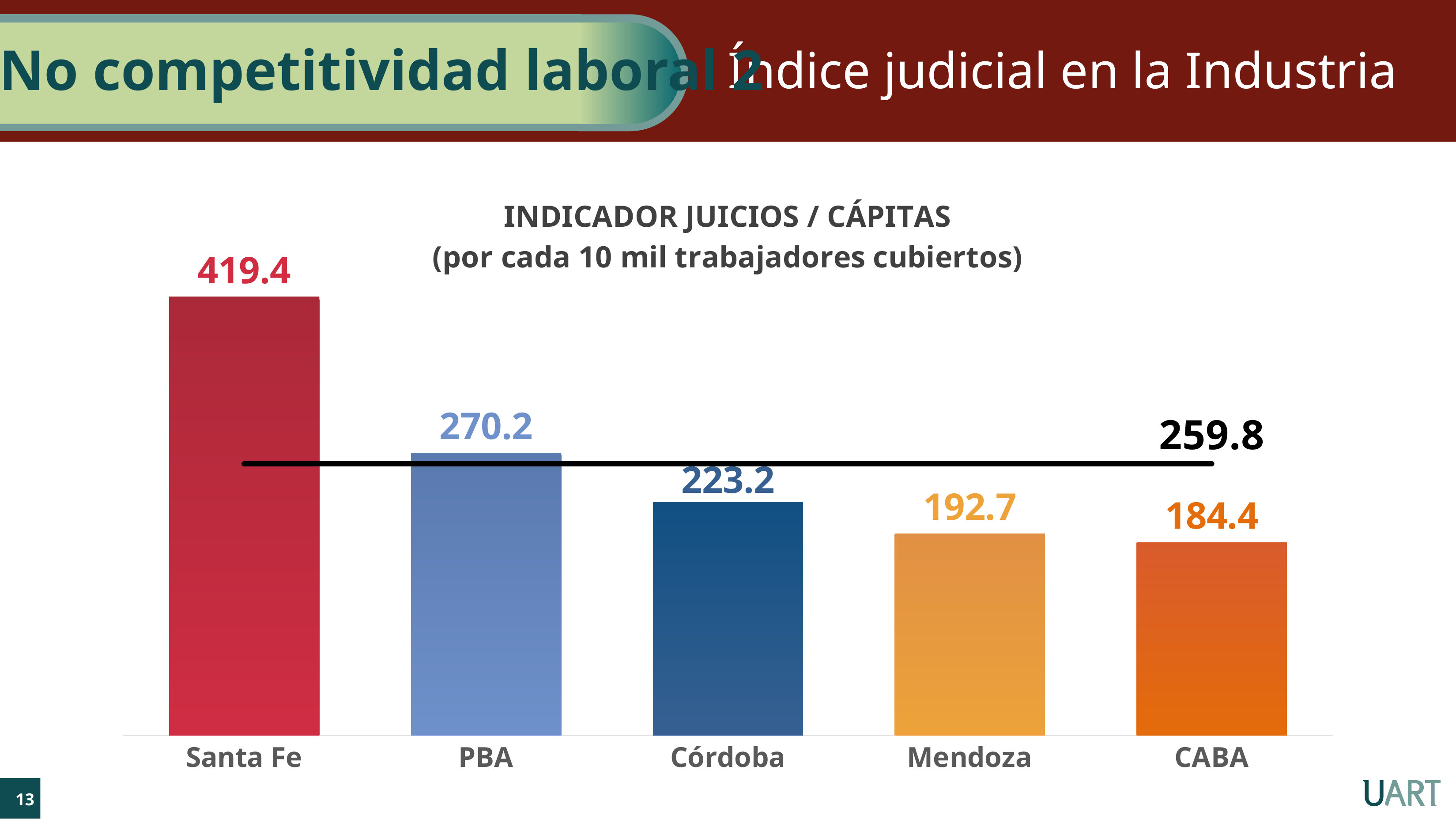
What is the value for CABA? 184.4 What kind of chart is shown on the slide? Bar chart Which category has the lowest value? CABA Which category has the highest value? Santa Fe Which is larger, the value for Córdoba or the value for Mendoza? Córdoba What is the difference between the values for Santa Fe and PBA? 149.2 What is the value for Santa Fe? 419.4 What is the value for PBA? 270.2 How many categories are shown on the x axis? 5 What value is labelled on the horizontal reference line drawn across the chart? 259.8 What is the value for Córdoba? 223.2 What is the value for Mendoza? 192.7